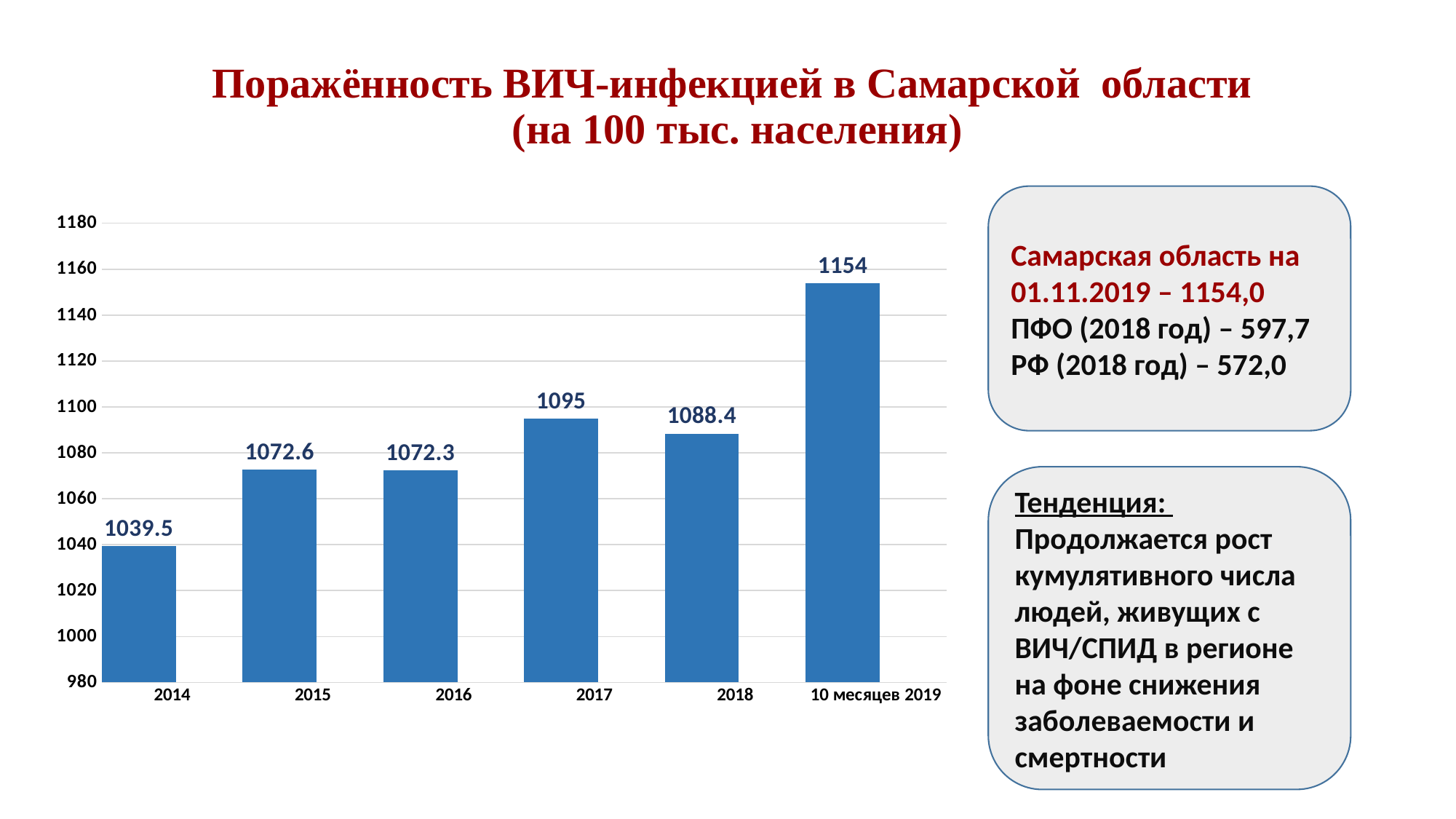
What is the value for 2014? 1039.5 Which is larger, the value for 2017 or the value for 2018? 2017 What kind of chart is this? bar chart Which category has the highest value? 10 месяцев 2019 Which category has the lowest value? 2014 What is the value for 2018? 1088.4 What is the difference between the values for 10 месяцев 2019 and 2018? 65.6 What is the title of the chart? Поражённость ВИЧ-инфекцией в Самарской области (на 100 тыс. населения) What is the value for 10 месяцев 2019? 1154 What is the difference between the values for 2017 and 2014? 55.5 What is the value for 2017? 1095 How many categories are shown on the x axis? 6